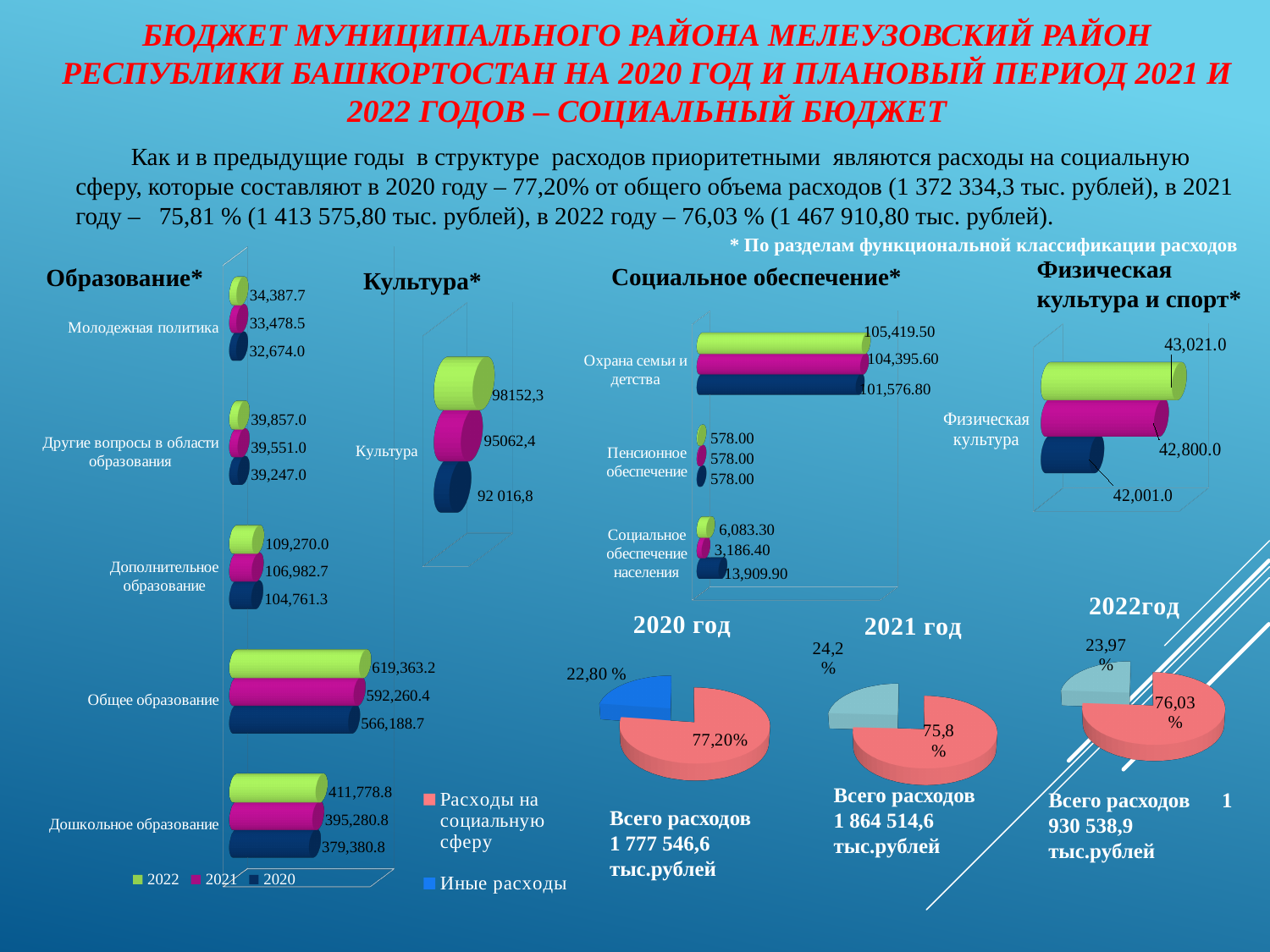
How many series does the legend of the Образование* chart list? 3 How many categories are shown in the Образование* chart? 5 In the Культура* chart, what is the value for 2021? 95062,4 In the Физическая культура и спорт* chart, what is the value for 2022? 43,021.0 In the Образование* chart, which category has the highest values? Общее образование In the Образование* chart, what is the difference between the 2022 and 2020 values for Дополнительное образование? 4,508.7 In the 2021 год pie chart, what share is Расходы на социальную сферу? 75,8 % In the Образование* chart, what is the 2020 value for Дошкольное образование? 379,380.8 In the Образование* chart, what is the 2022 value for Общее образование? 619,363.2 In the Образование* chart, which category has the lowest values? Молодежная политика In the Социальное обеспечение* chart, which is larger for Социальное обеспечение населения: the 2022 value or the 2021 value? 2022 In the Социальное обеспечение* chart, what is the 2020 value for Социальное обеспечение населения? 13,909.90